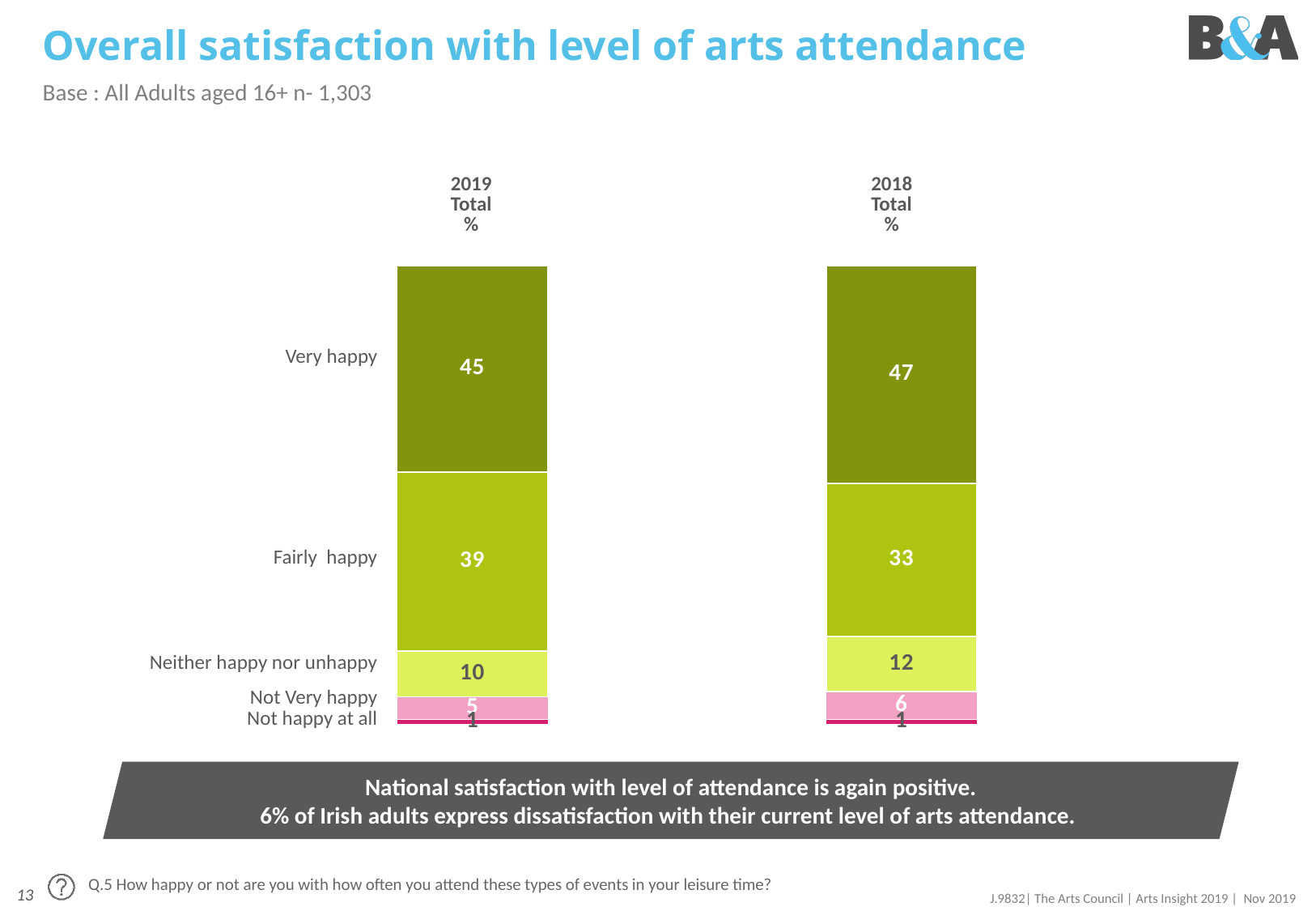
How many categories are stacked in each bar? 5 Which category has the smallest segment in the 2019 bar? Not happy at all What type of chart is shown on the slide? Stacked bar chart Which category has the largest segment in the 2018 bar? Very happy Which year has the higher 'Very happy' value, 2019 or 2018? 2018 What is the difference between the 'Fairly happy' values for 2019 and 2018? 6 What is the total of the 2019 stacked bar? 100 What is the value for 'Not Very happy' in the 2018 bar? 6 What is the title of the chart on the slide? Overall satisfaction with level of arts attendance What percentage of adults were 'Very happy' with their level of arts attendance in 2019? 45 What is the value for 'Neither happy nor unhappy' in the 2019 bar? 10 What percentage of adults were 'Fairly happy' in 2018? 33